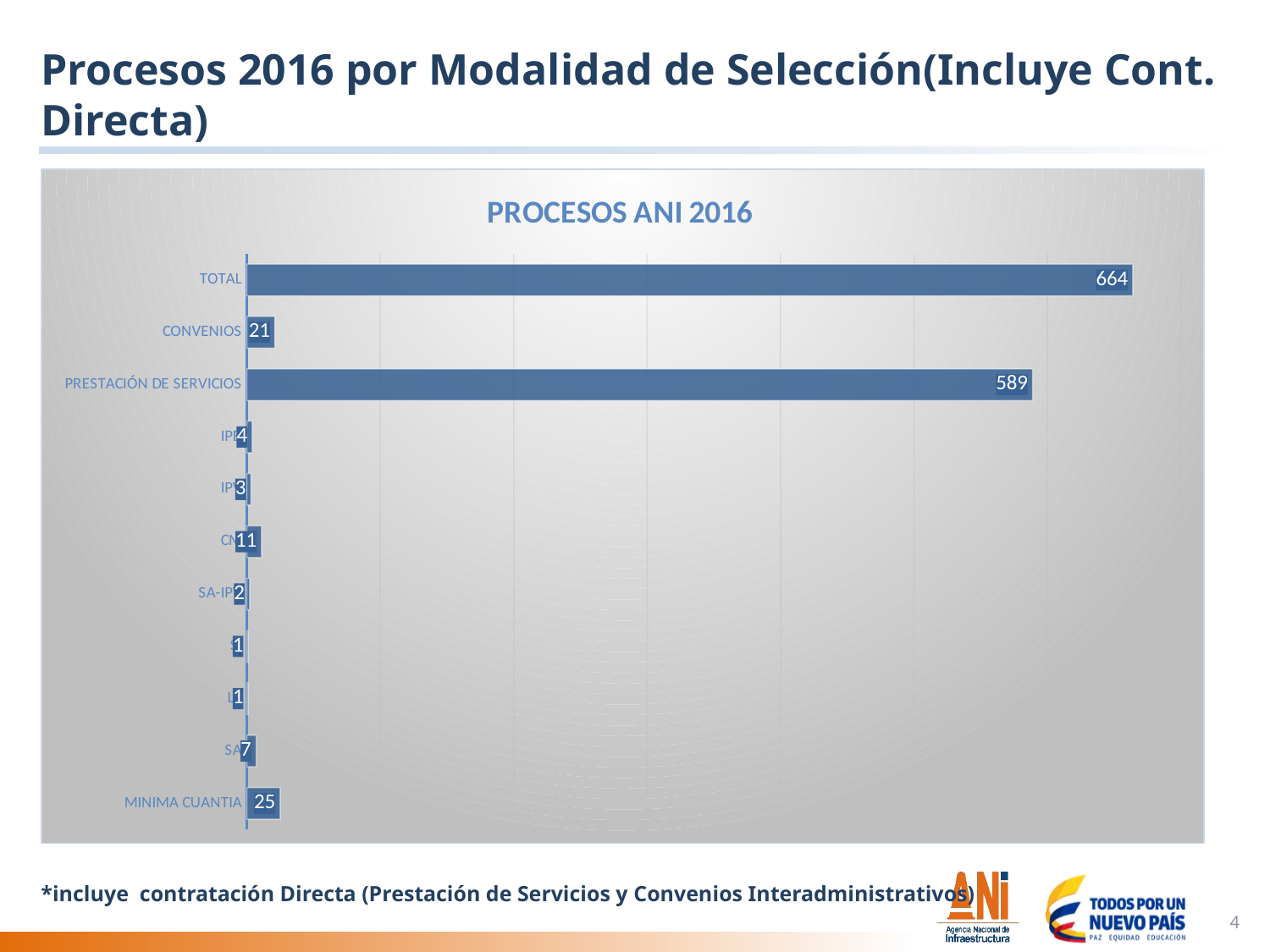
Which category has the highest value in the chart? TOTAL How many bars are plotted in the chart? 11 Which is larger, the value for CONVENIOS or the value for MINIMA CUANTIA? MINIMA CUANTIA What is the value for CONVENIOS? 21 What kind of chart is shown on the slide? Bar chart What is the title of the chart? PROCESOS ANI 2016 What is the difference between the TOTAL value and the PRESTACIÓN DE SERVICIOS value? 75 What is the value for SA-IP? 2 What is the difference between the MINIMA CUANTIA value and the CONVENIOS value? 4 What is the value for MINIMA CUANTIA? 25 What is the value for PRESTACIÓN DE SERVICIOS? 589 What is the value for TOTAL in the PROCESOS ANI 2016 chart? 664